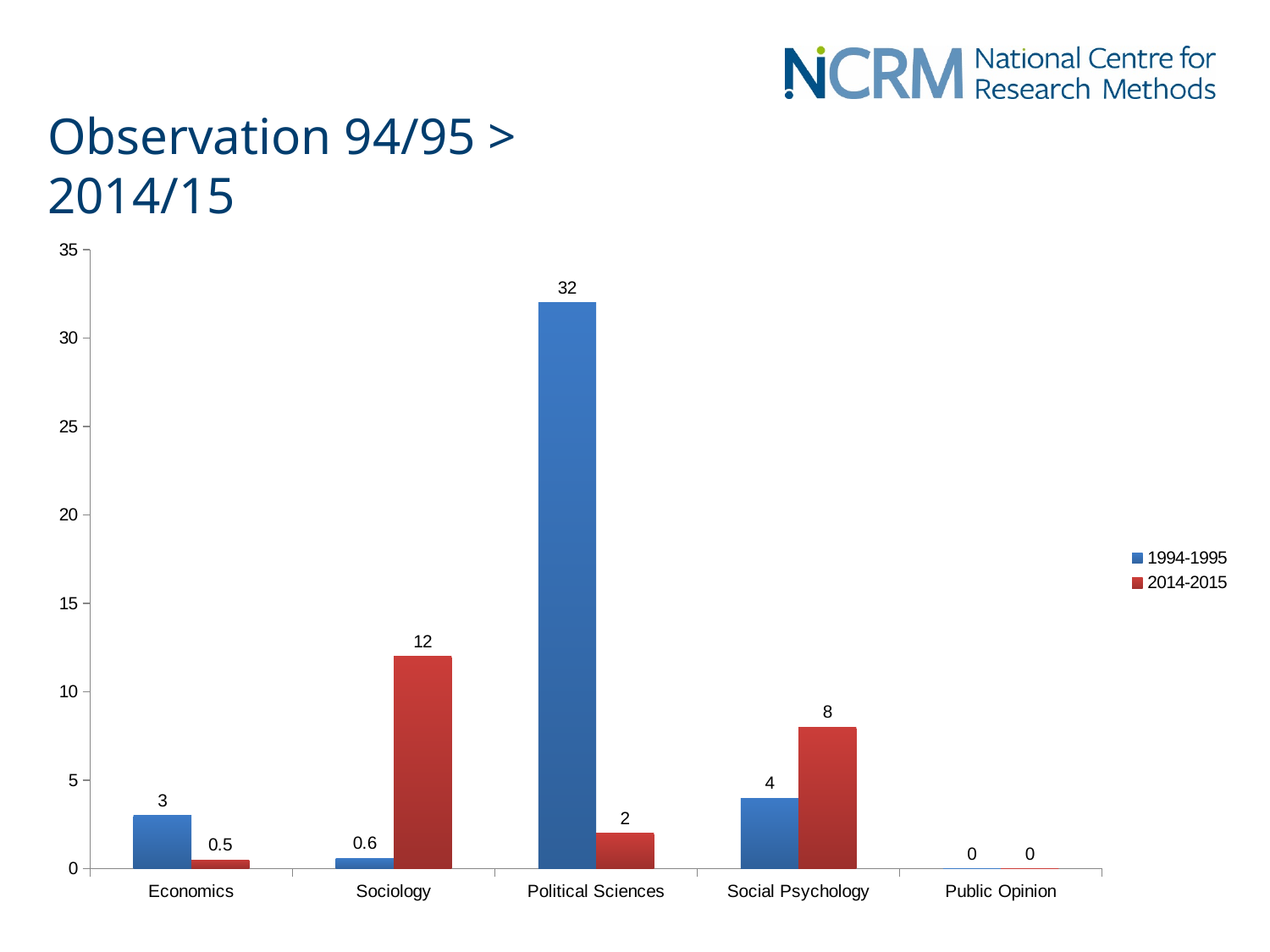
What is the value for Economics in the 2014-2015 series? 0.5 What is the value for Political Sciences in the 1994-1995 series? 32 What is the difference between the 1994-1995 and 2014-2015 values for Political Sciences? 30 For Sociology, which series has the larger value, 1994-1995 or 2014-2015? 2014-2015 Which category has the highest value in the 1994-1995 series? Political Sciences How many categories are shown on the x axis? 5 What kind of chart is shown on the slide? Bar chart What is the value for Sociology in the 2014-2015 series? 12 How many series does the legend list? 2 Which category has the highest value in the 2014-2015 series? Sociology What is the difference between the 2014-2015 and 1994-1995 values for Social Psychology? 4 What is the value for Public Opinion in the 1994-1995 series? 0